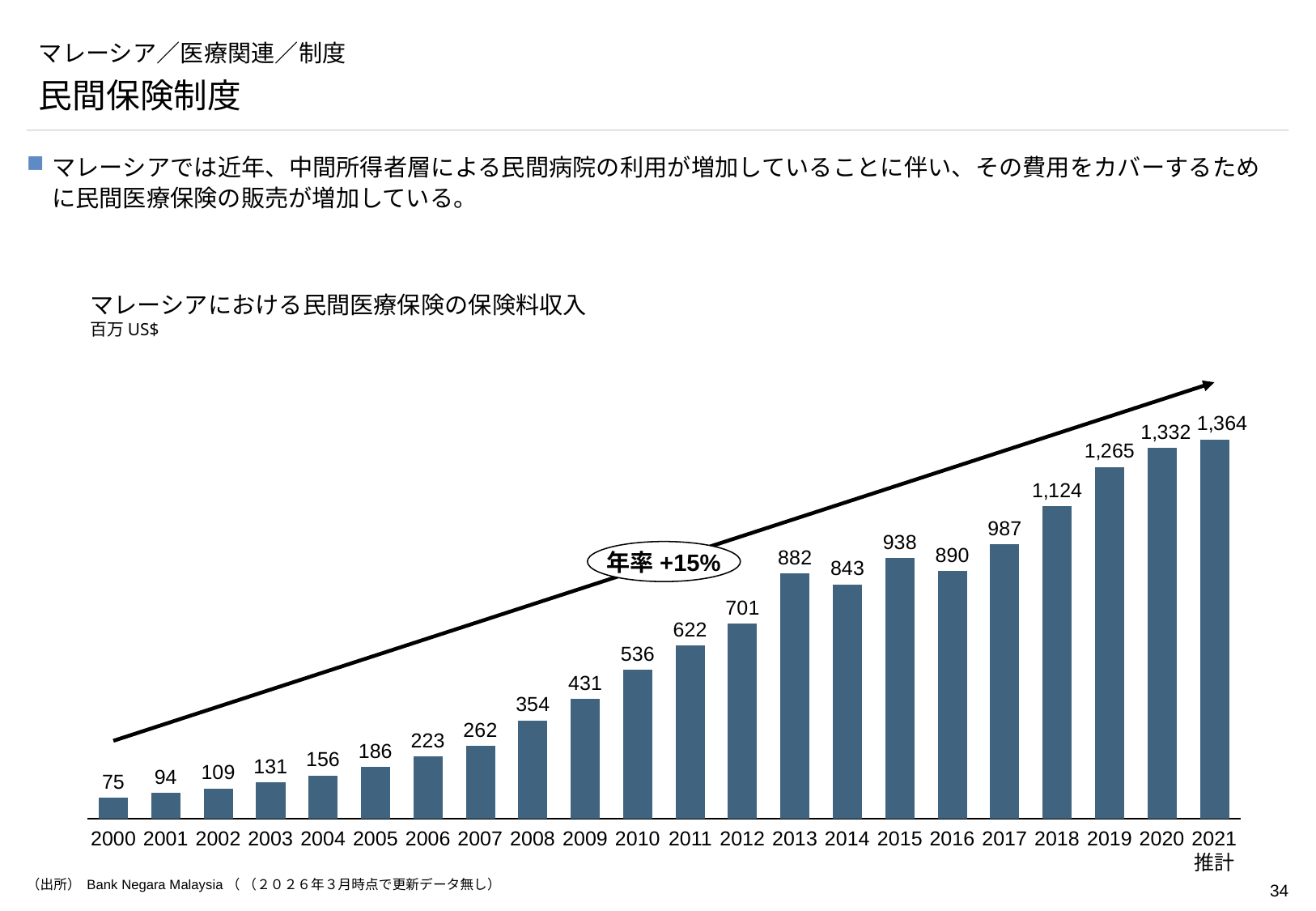
What is the value for 2000? 75 Do the values generally rise or fall from 2000 to 2021? Rise How many years are shown on the x axis? 22 What is the value for 2021 (推計)? 1,364 What annual growth rate is annotated on the chart? 年率 +15% What kind of chart is this? Bar chart What unit is stated under the chart title? 百万 US$ Which year has the lowest value? 2000 Which is larger, the value for 2015 or the value for 2016? 2015 What is the difference between the values for 2013 and 2014? 39 Which year has the highest value? 2021 What is the value for 2010? 536